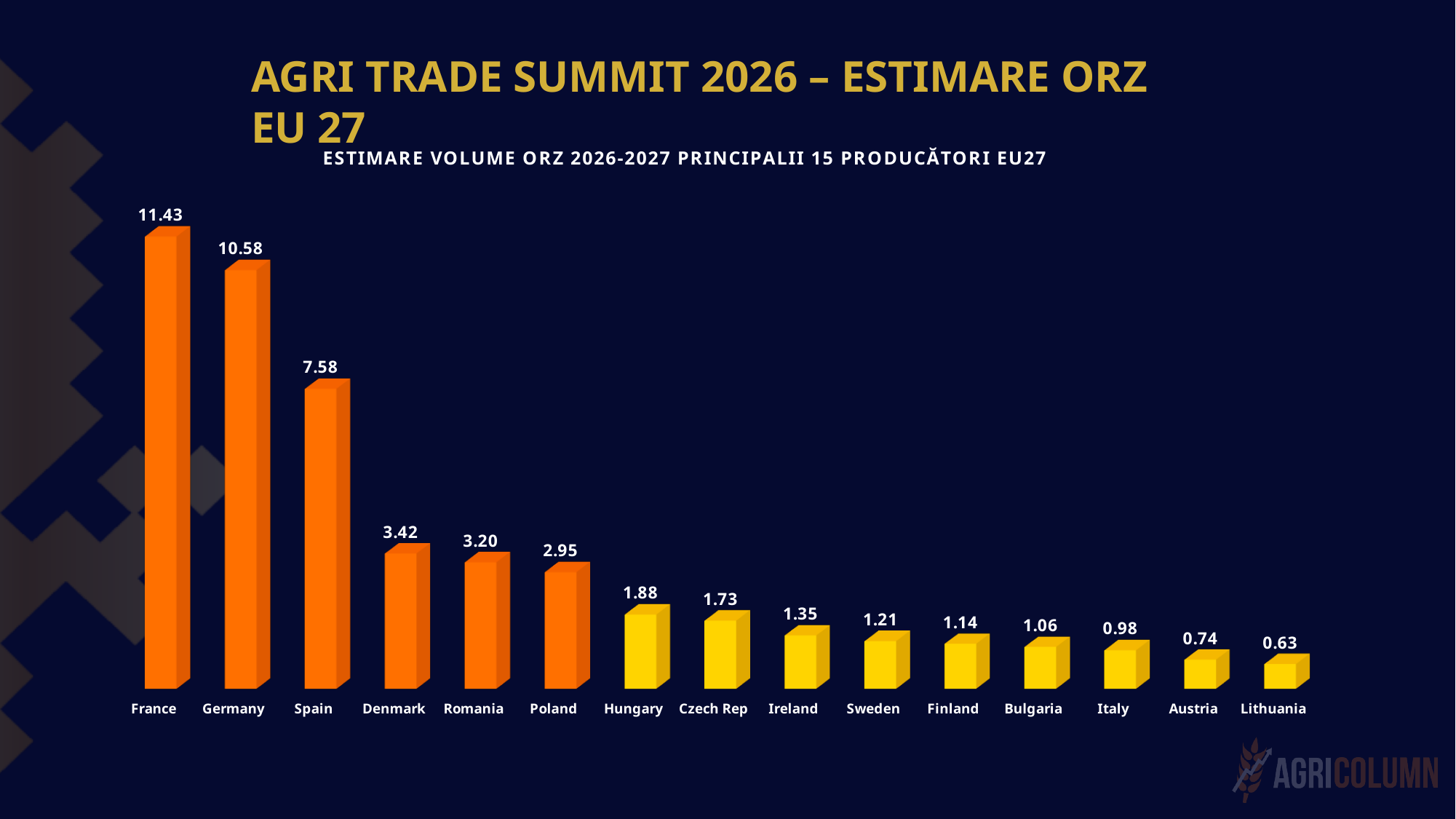
How many countries are shown in the chart? 15 What is the estimated barley volume for France? 11.43 What is the title of the chart? ESTIMARE VOLUME ORZ 2026-2027 PRINCIPALII 15 PRODUCĂTORI EU27 What kind of chart is shown on the slide? Bar chart What is the difference between the values for Spain and Denmark? 4.16 Which country has the highest estimated barley volume? France What is the difference between the values for France and Germany? 0.85 Which has a larger value, Poland or Hungary? Poland What is the value shown for Czech Rep? 1.73 Which country has the lowest estimated barley volume? Lithuania Do the values rise or fall from left to right along the x axis? Fall What is the value shown for Romania? 3.20